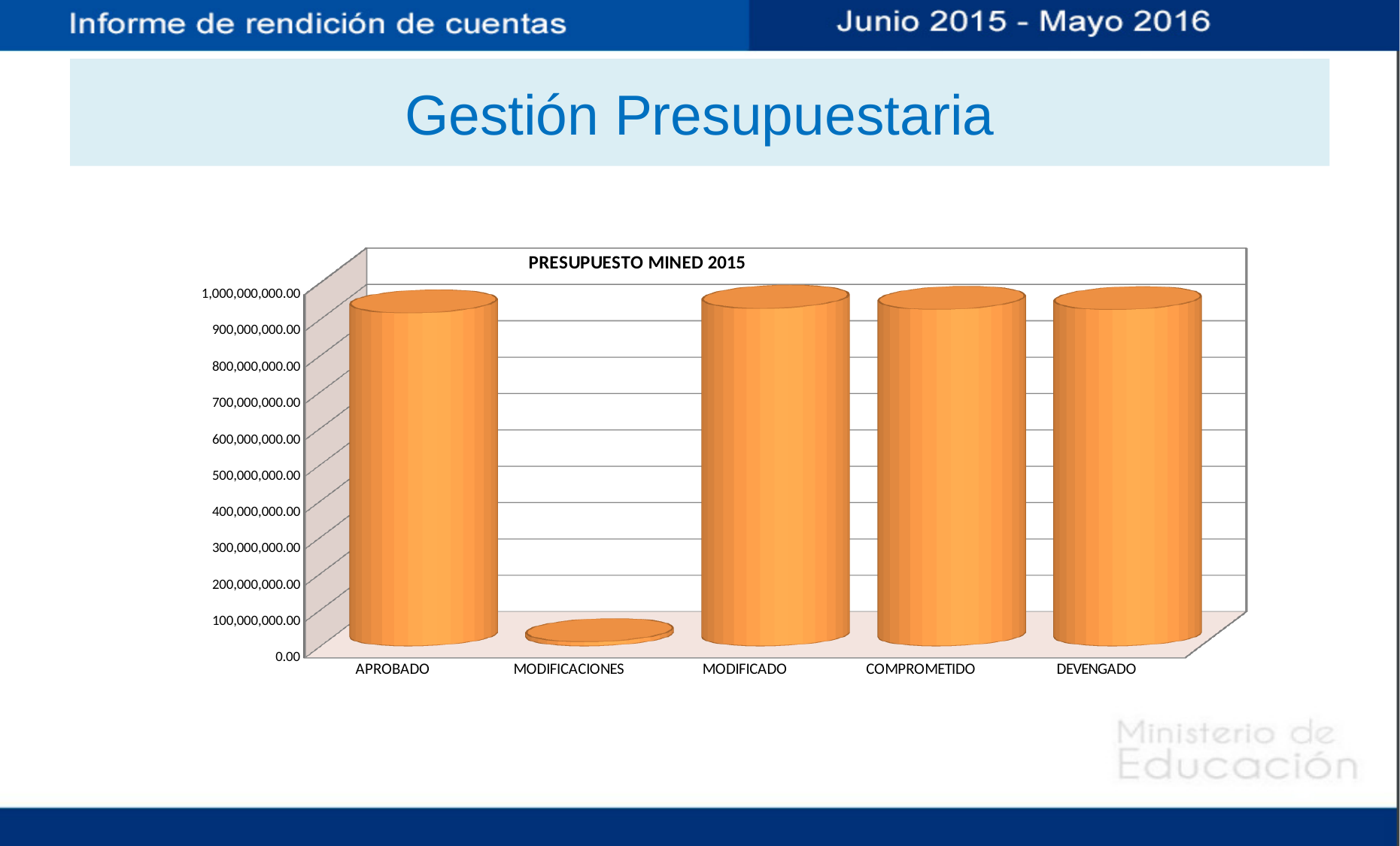
Is the value for MODIFICACIONES greater or less than 100,000,000.00? less What is the label of the first category on the x axis? APROBADO Is the value for APROBADO greater or less than 800,000,000.00? greater What is the title of the chart? PRESUPUESTO MINED 2015 Which is larger, the value for MODIFICACIONES or the value for COMPROMETIDO? COMPROMETIDO Is the value for DEVENGADO greater or less than 500,000,000.00? greater Which is larger, the value for APROBADO or the value for MODIFICACIONES? APROBADO How many categories are shown on the x axis of the chart? 5 Which category has the lowest value in the chart? MODIFICACIONES What kind of chart is shown on the slide? bar chart What is the highest value shown on the vertical axis of the chart? 1,000,000,000.00